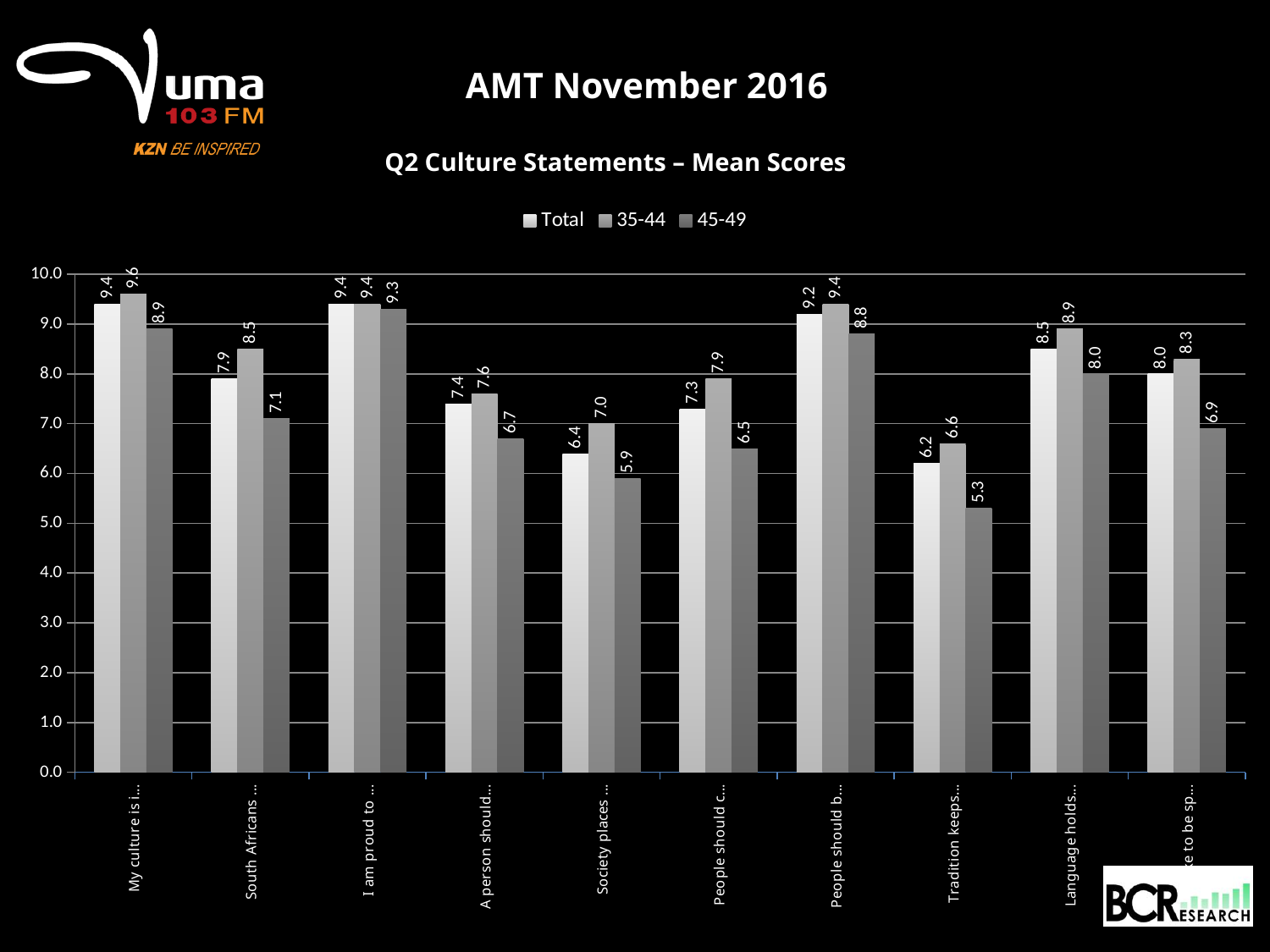
Which statement has the lowest 45-49 mean score? Tradition keeps... What is the 45-49 mean score for the statement beginning "Language holds"? 8.0 How many series does the legend list? 3 What is the 35-44 mean score for the statement beginning "Society places"? 7.0 Is the 45-49 mean score for the statement beginning "A person should" greater or less than 7.0? less What is the title of the chart? Q2 Culture Statements – Mean Scores What is the Total mean score for the statement beginning "Tradition keeps"? 6.2 How many categories (culture statements) are plotted on the chart? 10 What type of chart is shown on the slide? bar chart For the statement beginning "People should b", which is larger: the Total score or the 45-49 score? Total What is the difference between the 35-44 and 45-49 mean scores for the statement beginning "South Africans"? 1.4 Which statement has the highest 35-44 mean score? My culture is i...